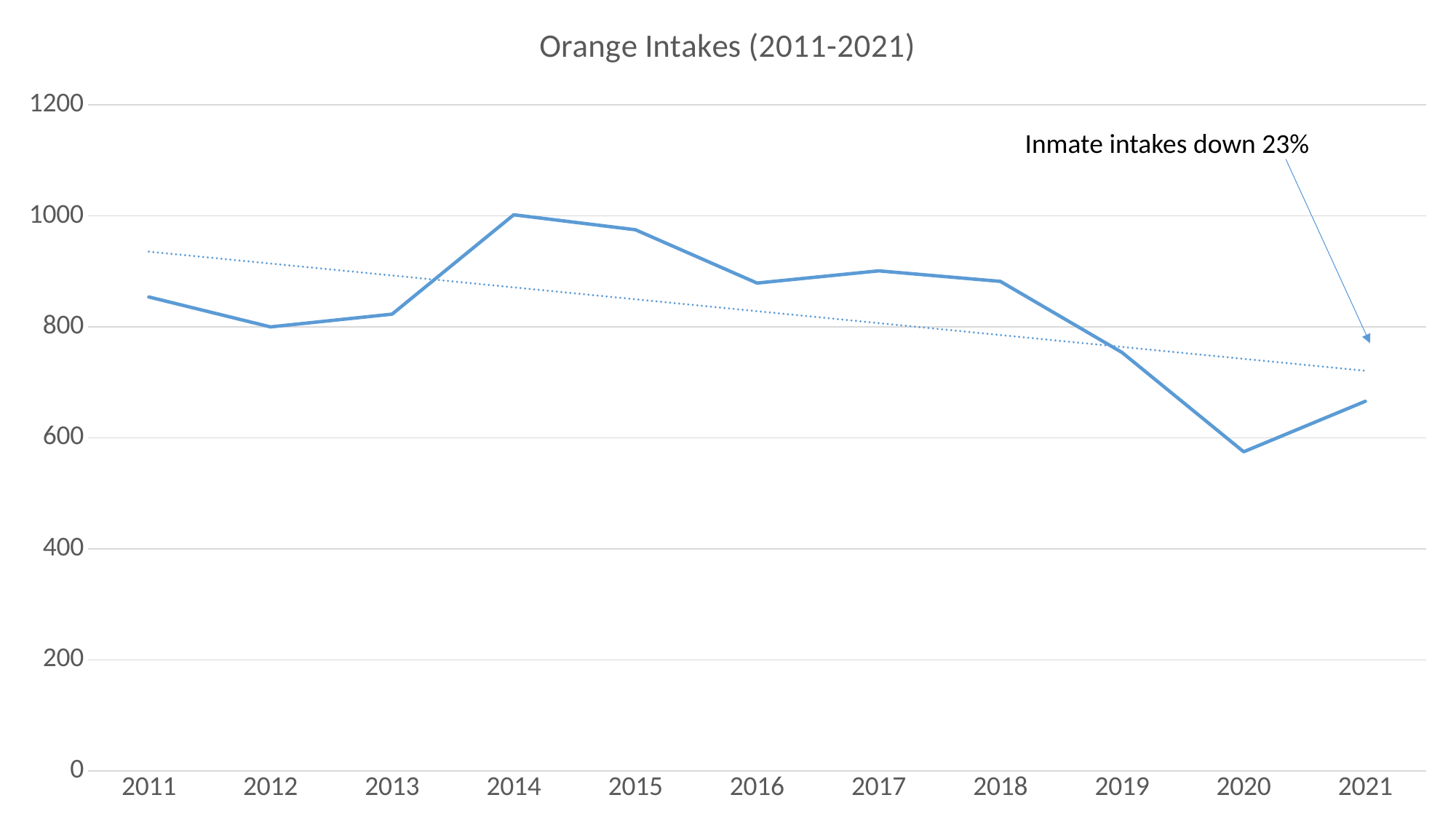
Is the value for 2021 greater or less than 600? greater In which year is the value highest? 2014 What is the title of the chart? Orange Intakes (2011-2021) What kind of chart is shown on the slide? line chart Which year has the larger value, 2011 or 2021? 2011 What does the annotation text on the chart say? Inmate intakes down 23% Is the value for 2020 greater or less than 600? less Is the value for 2019 greater or less than 800? less Overall, do the values rise or fall from 2011 to 2021? fall In which year is the value lowest? 2020 How many years are plotted along the x axis? 11